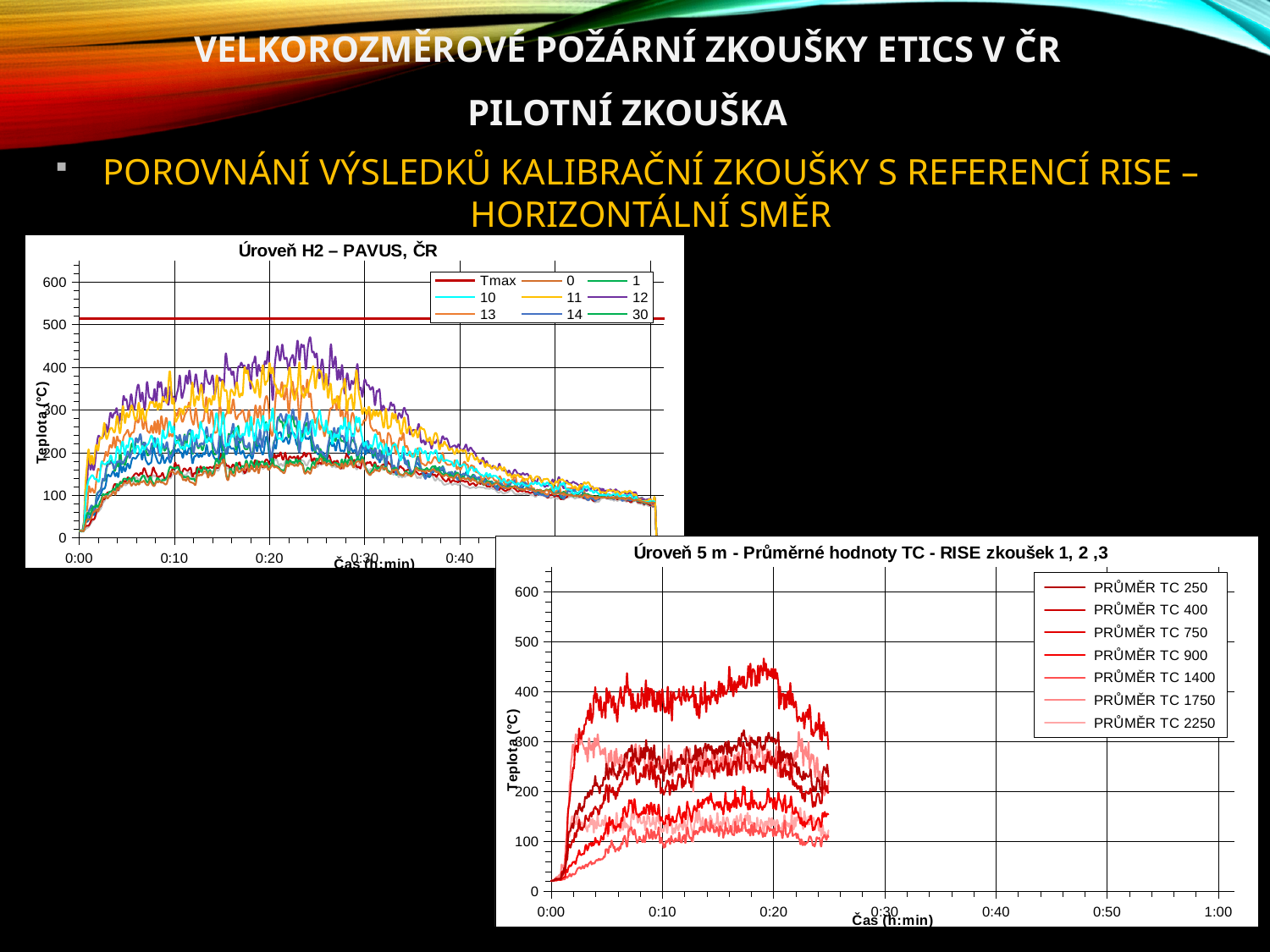
What is the last x-axis tick label on the chart "Úroveň 5 m - Průměrné hodnoty TC - RISE zkoušek 1, 2 ,3"? 1:00 In the chart "Úroveň 5 m - Průměrné hodnoty TC - RISE zkoušek 1, 2 ,3", is the highest peak reached by any series greater or less than 400? greater In the chart "Úroveň 5 m - Průměrné hodnoty TC - RISE zkoušek 1, 2 ,3", is the value of the lowest series at 0:20 greater or less than 200? less In the chart "Úroveň 5 m - Průměrné hodnoty TC - RISE zkoušek 1, 2 ,3", do the temperatures rise or fall between 0:00 and 0:05? rise What kind of chart is the chart titled "Úroveň 5 m - Průměrné hodnoty TC - RISE zkoušek 1, 2 ,3"? line chart What is the y-axis label of the chart "Úroveň H2 – PAVUS, ČR"? Teplota (°C) How many series does the legend of the chart "Úroveň 5 m - Průměrné hodnoty TC - RISE zkoušek 1, 2 ,3" list? 7 In the chart "Úroveň H2 – PAVUS, ČR", do the temperatures rise or fall between 0:30 and 0:40? fall In the chart "Úroveň H2 – PAVUS, ČR", is the peak value of series 12 greater or less than 400? greater What kind of chart is the chart titled "Úroveň H2 – PAVUS, ČR"? line chart How many series does the legend of the chart "Úroveň H2 – PAVUS, ČR" list? 9